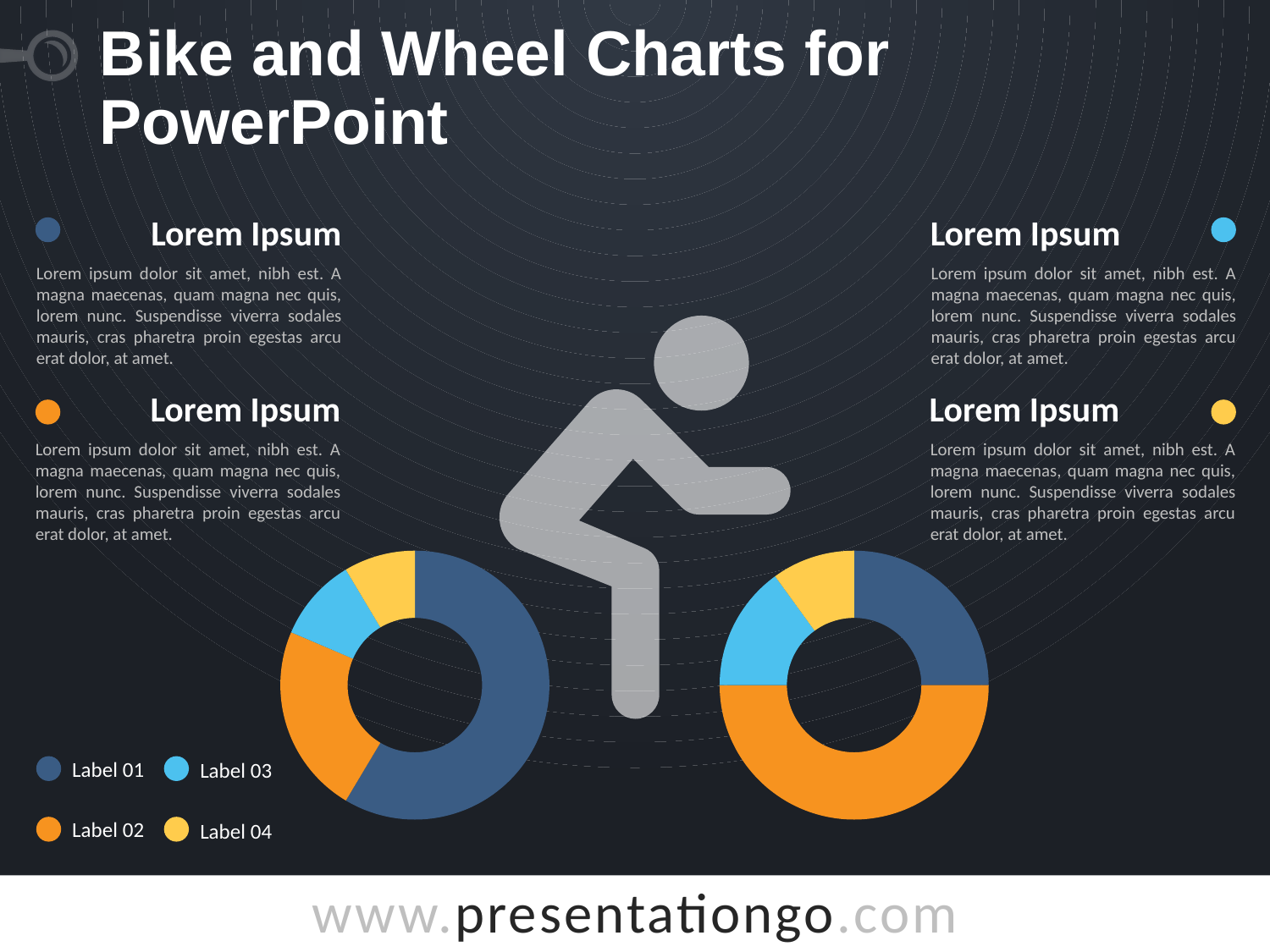
In the right wheel chart, which label has the largest slice? Label 02 In the left wheel chart, which label has the largest slice? Label 01 In the right wheel chart, which is larger, the slice for Label 01 or the slice for Label 03? Label 01 What colour represents Label 02 in the legend? orange What kind of chart is the right wheel chart? doughnut chart What kind of chart is the left wheel chart? doughnut chart How many entries does the legend list? 4 In the right wheel chart, which is larger, the slice for Label 02 or the slice for Label 01? Label 02 How many slices does the right wheel chart have? 4 How many charts are shown on the slide? 2 In the left wheel chart, which is larger, the slice for Label 01 or the slice for Label 02? Label 01 How many slices does the left wheel chart have? 4